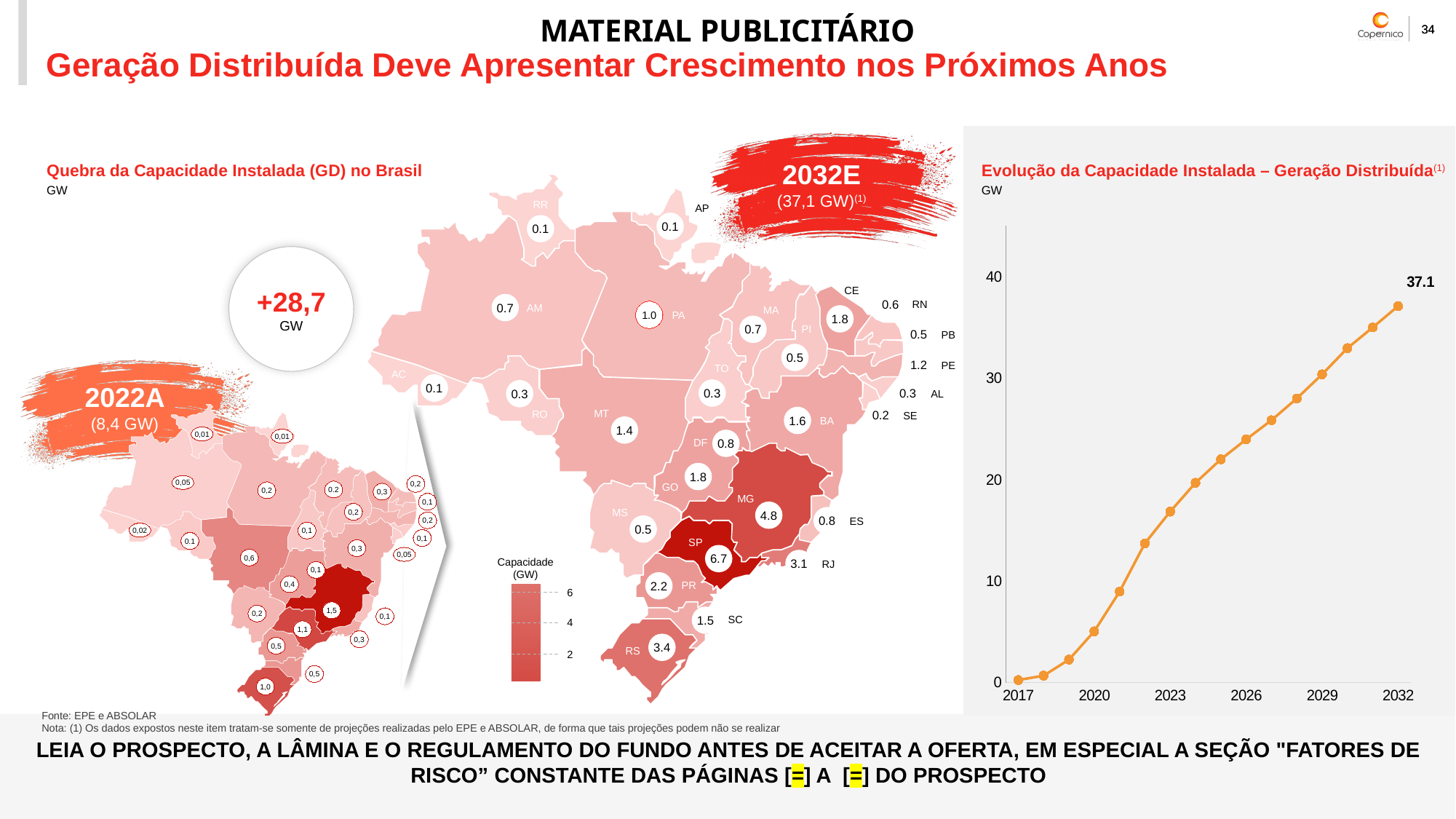
On the 2032E map 'Quebra da Capacidade Instalada (GD) no Brasil', what is the difference between the values for SP and MG? 1.9 In the chart 'Evolução da Capacidade Instalada – Geração Distribuída', do the values rise or fall from 2017 to 2032? rise In the chart 'Evolução da Capacidade Instalada – Geração Distribuída', what is the value for 2032? 37.1 On the 2032E map 'Quebra da Capacidade Instalada (GD) no Brasil', which has the larger value, MG or RS? MG How many data points are plotted in the chart 'Evolução da Capacidade Instalada – Geração Distribuída'? 16 In the chart 'Evolução da Capacidade Instalada – Geração Distribuída', which year has the highest value? 2032 In the chart 'Evolução da Capacidade Instalada – Geração Distribuída', is the value for 2026 greater or less than 20? greater In the chart 'Evolução da Capacidade Instalada – Geração Distribuída', which year has the lowest value? 2017 In the chart 'Evolução da Capacidade Instalada – Geração Distribuída', is the value for 2023 greater or less than 10? greater What kind of chart is 'Evolução da Capacidade Instalada – Geração Distribuída'? line chart In the chart 'Evolução da Capacidade Instalada – Geração Distribuída', is the value for 2020 greater or less than 10? less On the 2032E map 'Quebra da Capacidade Instalada (GD) no Brasil', which state has the highest capacity? SP